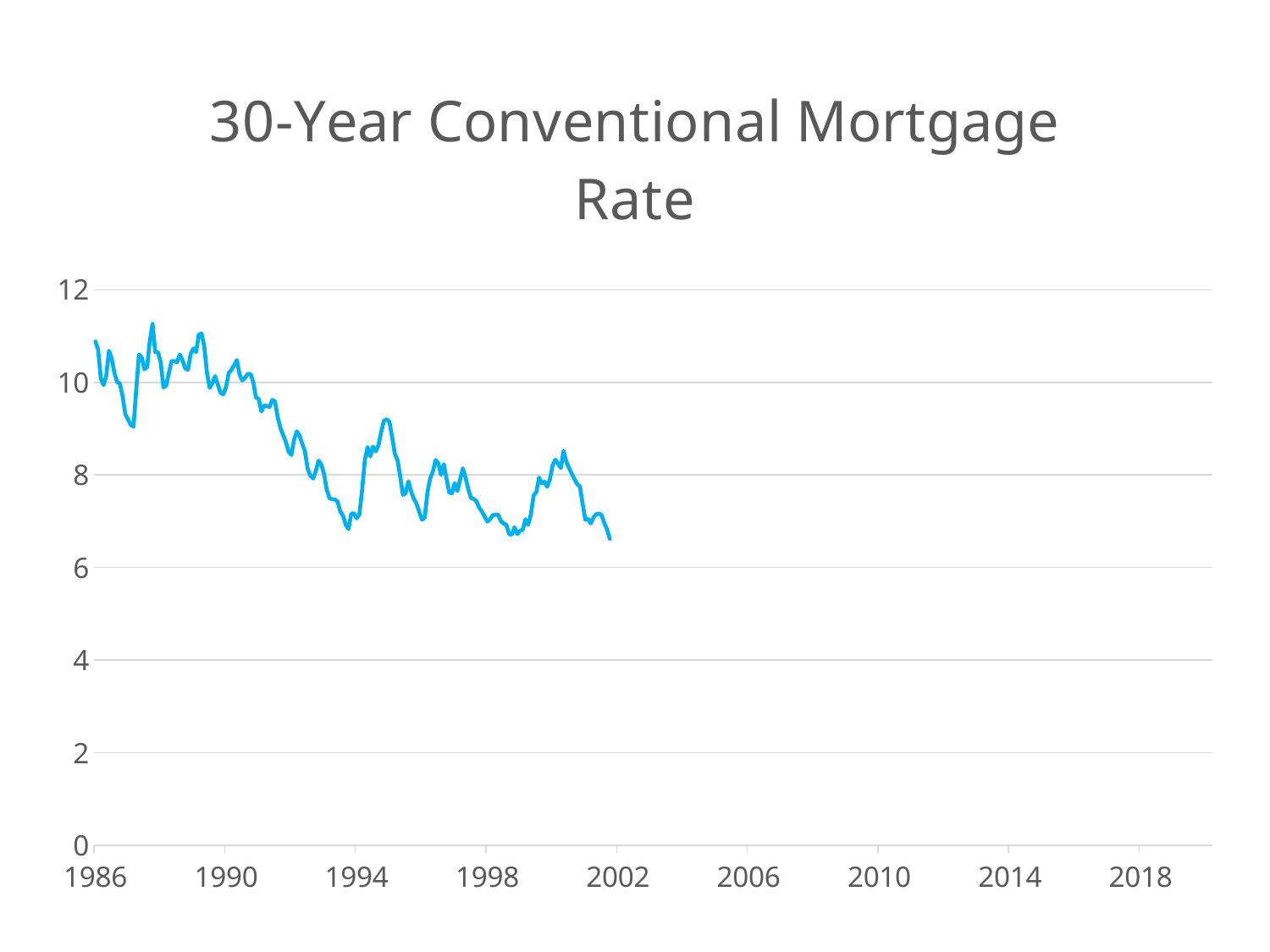
Is the mortgage rate at the end of the plotted line (around 2001) greater or less than 6? greater Is the mortgage rate at the start of 1986 greater or less than 10? greater What kind of chart is shown on the slide? line chart Is the mortgage rate at the end of the plotted line (around 2001) greater or less than 8? less Is the mortgage rate around 1990 higher or lower than around 1998? higher Overall, does the mortgage rate rise or fall from 1986 to the end of the plotted line? fall What is the highest value labelled on the y axis? 12 What is the title of the chart? 30-Year Conventional Mortgage Rate Is the mortgage rate higher around 1988 or around 1994? around 1988